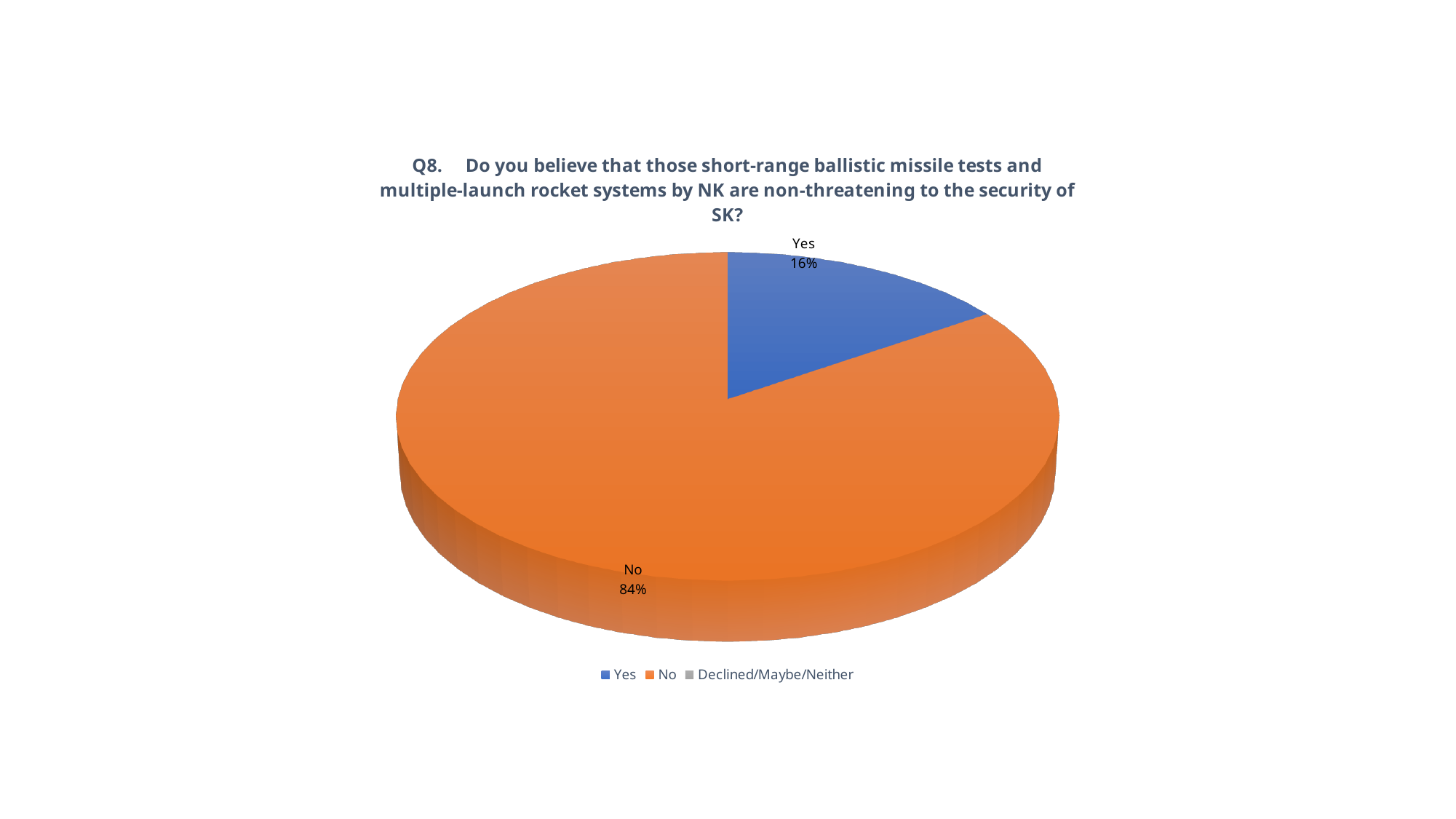
What is the third legend entry, after Yes and No? Declined/Maybe/Neither What kind of chart is shown on the slide? Pie chart Which response has the largest slice of the pie? No What colour is the Yes slice? Blue What share of the pie is labelled "Yes"? 16% Is the share for No greater or less than 50%? greater What is the difference in percentage points between the No slice and the Yes slice? 68 How many slices have a percentage label printed on the chart? 2 Which slice is larger, Yes or No? No How many entries does the legend list? 3 Which of the two labelled slices, Yes or No, is the smaller one? Yes What share of the pie is labelled "No"? 84%